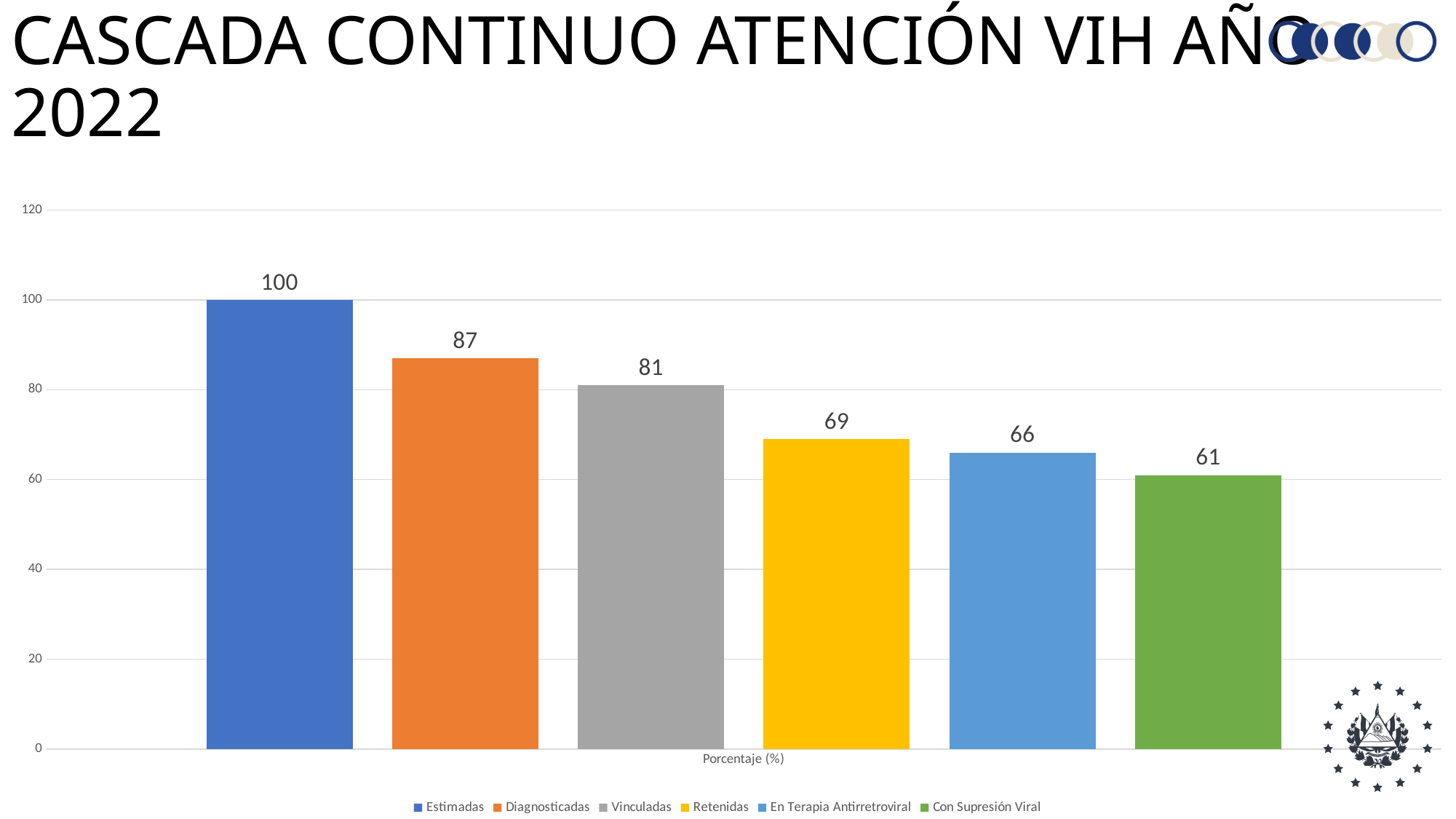
Which is larger, the value for Retenidas or the value for En Terapia Antirretroviral? Retenidas What is the value for Con Supresión Viral? 61 What kind of chart is shown on the slide? Bar chart What is the value for Retenidas? 69 Which series has the highest value? Estimadas What is the value for Diagnosticadas? 87 What is the difference between the values for Vinculadas and En Terapia Antirretroviral? 15 What is the value for Estimadas? 100 Do the values rise or fall from left to right across the bars? Fall How many series does the legend list? 6 Which series has the lowest value? Con Supresión Viral What is the label shown on the x axis of the chart? Porcentaje (%)